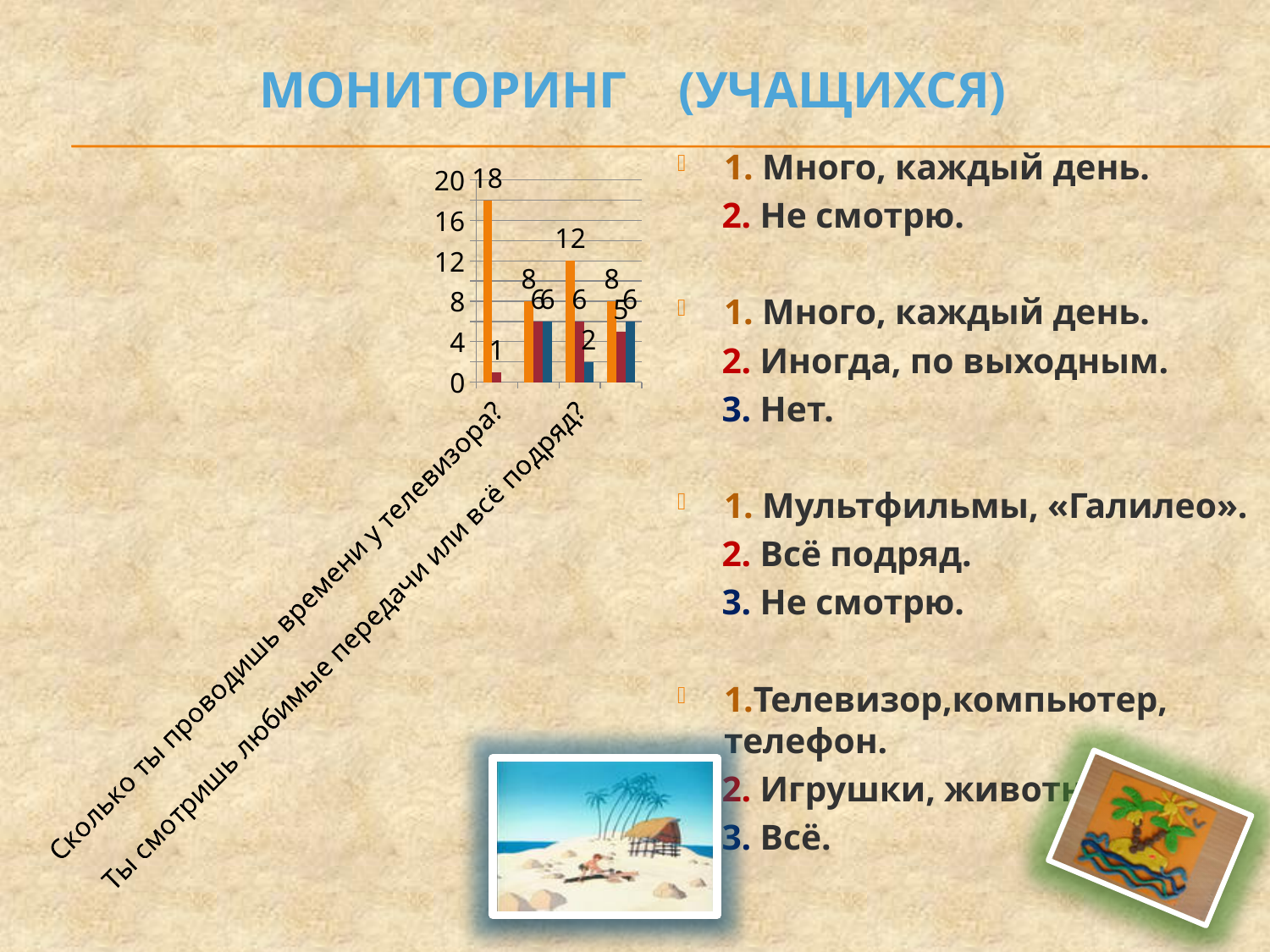
What is the value of the orange bar in the first (leftmost) group? 18 What kind of chart is shown on the slide? bar chart What is the highest value labelled on any bar in the chart? 18 What is the value of the orange bar in the third group? 12 Which is larger: the orange bar in the first group or the orange bar in the third group? the orange bar in the first group (18) What is the highest tick value shown on the vertical axis? 20 What is the value of the red bar in the first (leftmost) group? 1 How many groups of bars does the chart show? 4 How many different bar colours are used in the chart? 3 What is the difference between the orange bar (18) and the red bar (1) in the first group? 17 What is the value of the blue bar in the third group? 2 Is the tallest bar in the chart greater or less than 16? greater